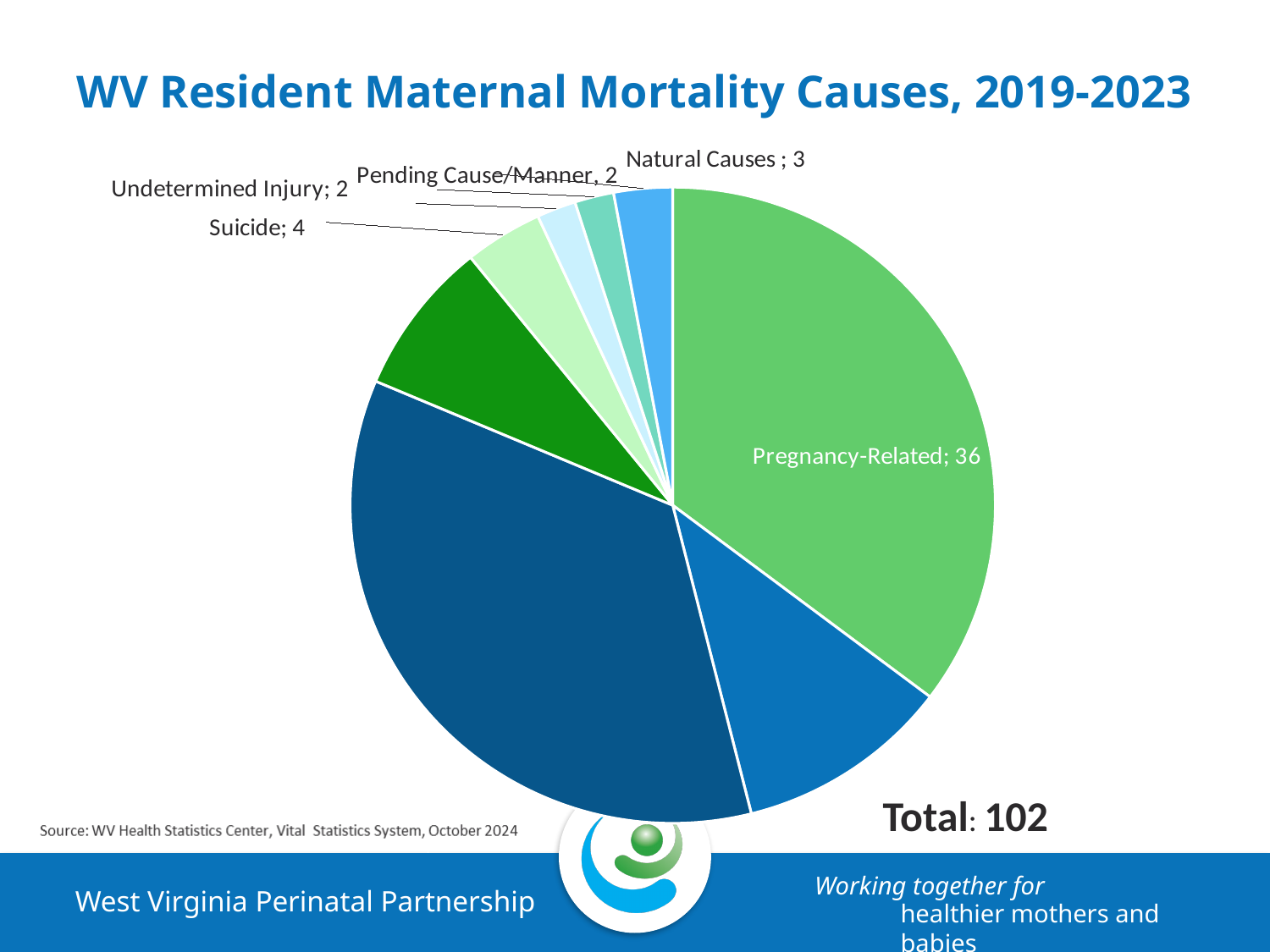
What is the title of the chart? WV Resident Maternal Mortality Causes, 2019-2023 What is the difference between the values for Pregnancy-Related and Suicide? 32 What is the value for Pending Cause/Manner? 2 What is the value for Natural Causes? 3 What is the value for Undetermined Injury? 2 What is the value for Pregnancy-Related? 36 What total is printed on the slide for the chart? 102 How many slices does the pie chart have? 8 What type of chart is shown on the slide? pie chart What is the difference between the values for Suicide and Natural Causes? 1 What is the value for Suicide? 4 Which is larger, the value for Suicide or the value for Natural Causes? Suicide